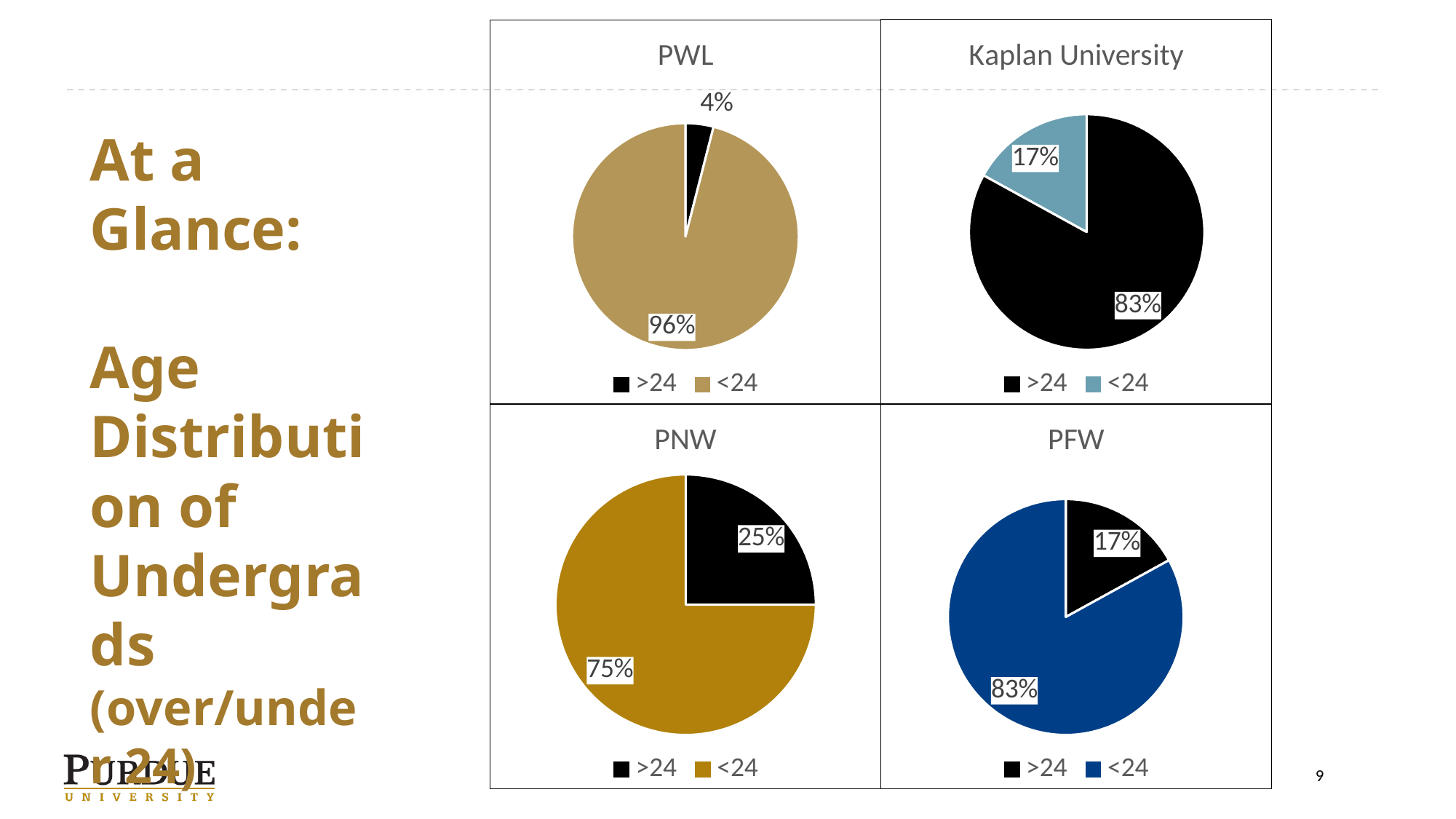
In the Kaplan University chart, what share of undergraduates are under 24 (<24)? 17% In the PNW chart, what share of undergraduates are over 24 (>24)? 25% In the PWL chart, what share of undergraduates are over 24 (>24)? 4% How many slices does the PNW chart have? 2 In the PWL chart, what share of undergraduates are under 24 (<24)? 96% In the PNW chart, which slice is larger, >24 or <24? <24 How many charts are shown on the slide? 4 In the PFW chart, what share of undergraduates are under 24 (<24)? 83% In the PFW chart, what is the difference between the <24 share and the >24 share? 66% In the Kaplan University chart, which slice is the largest? >24 In the Kaplan University chart, what share of undergraduates are over 24 (>24)? 83% What kind of chart is used for PWL? Pie chart